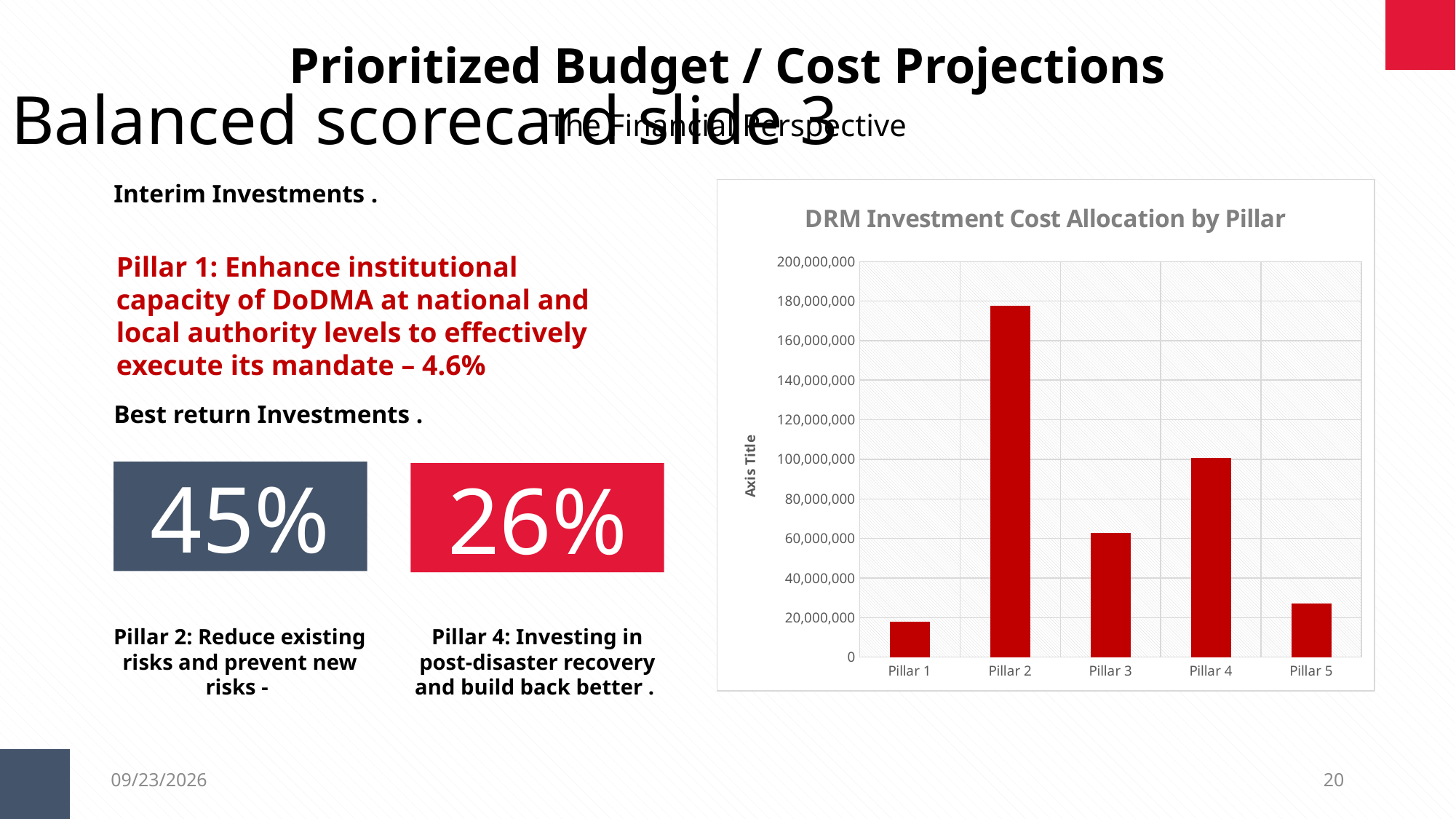
Which pillar has the lowest investment cost allocation? Pillar 1 Is the value for Pillar 1 greater or less than 40,000,000? less Is the value for Pillar 2 greater or less than 160,000,000? greater Is the value for Pillar 3 greater or less than 40,000,000? greater How many pillars are plotted on the x axis of the chart? 5 What label is shown on the vertical axis of the chart? Axis Title Which pillar has the highest investment cost allocation? Pillar 2 What type of chart is shown on the slide? bar chart Which has a larger value, Pillar 3 or Pillar 4? Pillar 4 What is the title of the chart? DRM Investment Cost Allocation by Pillar Which has a larger value, Pillar 2 or Pillar 4? Pillar 2